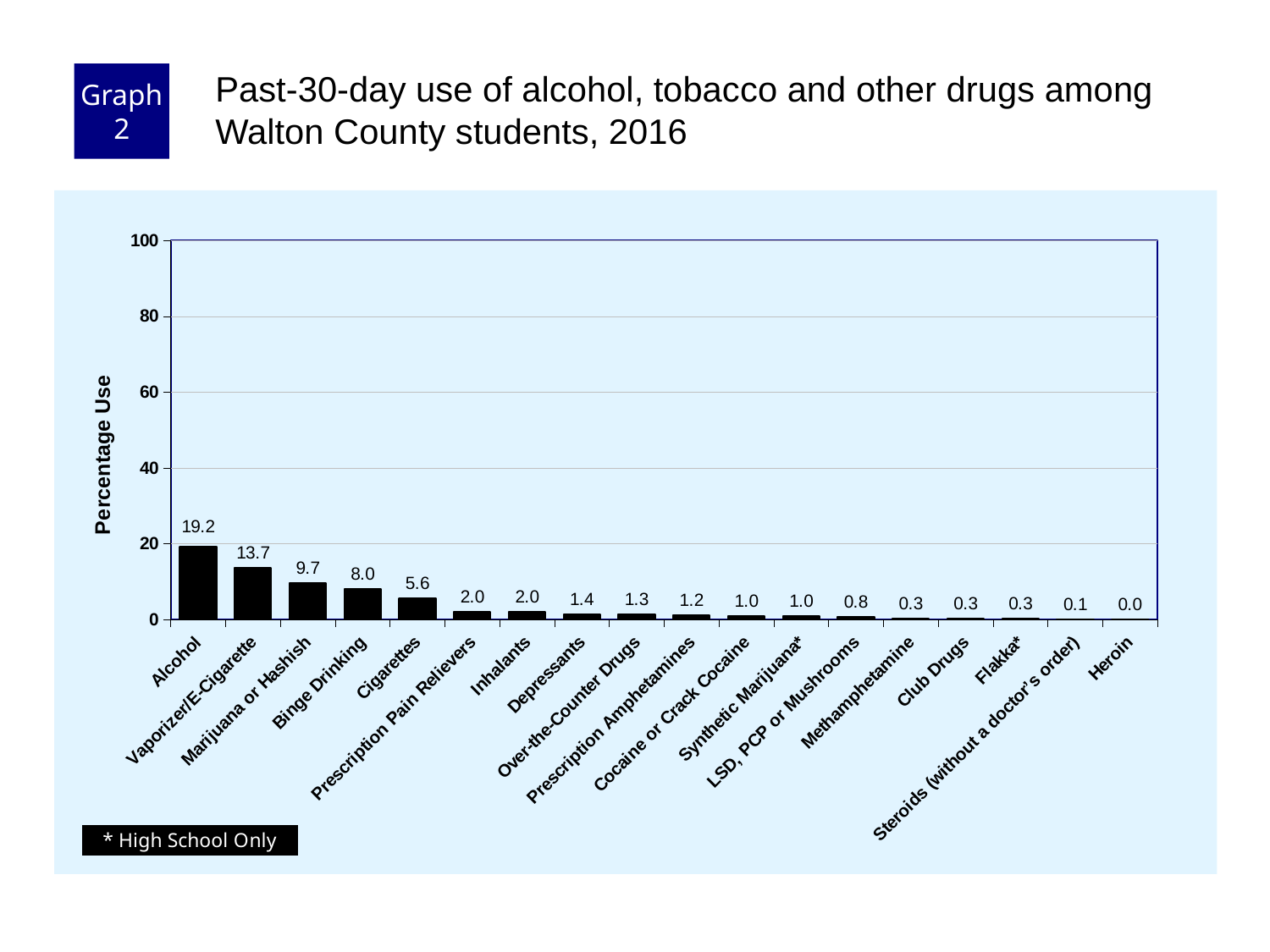
Is the value for Alcohol greater or less than 20? less What is the label of the y axis? Percentage Use What kind of chart is shown on the slide? bar chart How many categories are shown on the x axis? 18 Which has a higher percentage use, Marijuana or Hashish or Binge Drinking? Marijuana or Hashish What is the percentage use for Alcohol? 19.2 What is the percentage use for Cigarettes? 5.6 Which category has the highest percentage use? Alcohol What is the percentage use for Binge Drinking? 8.0 What is the difference in percentage use between Alcohol and Vaporizer/E-Cigarette? 5.5 What is the percentage use for Vaporizer/E-Cigarette? 13.7 Which category has the lowest percentage use? Heroin